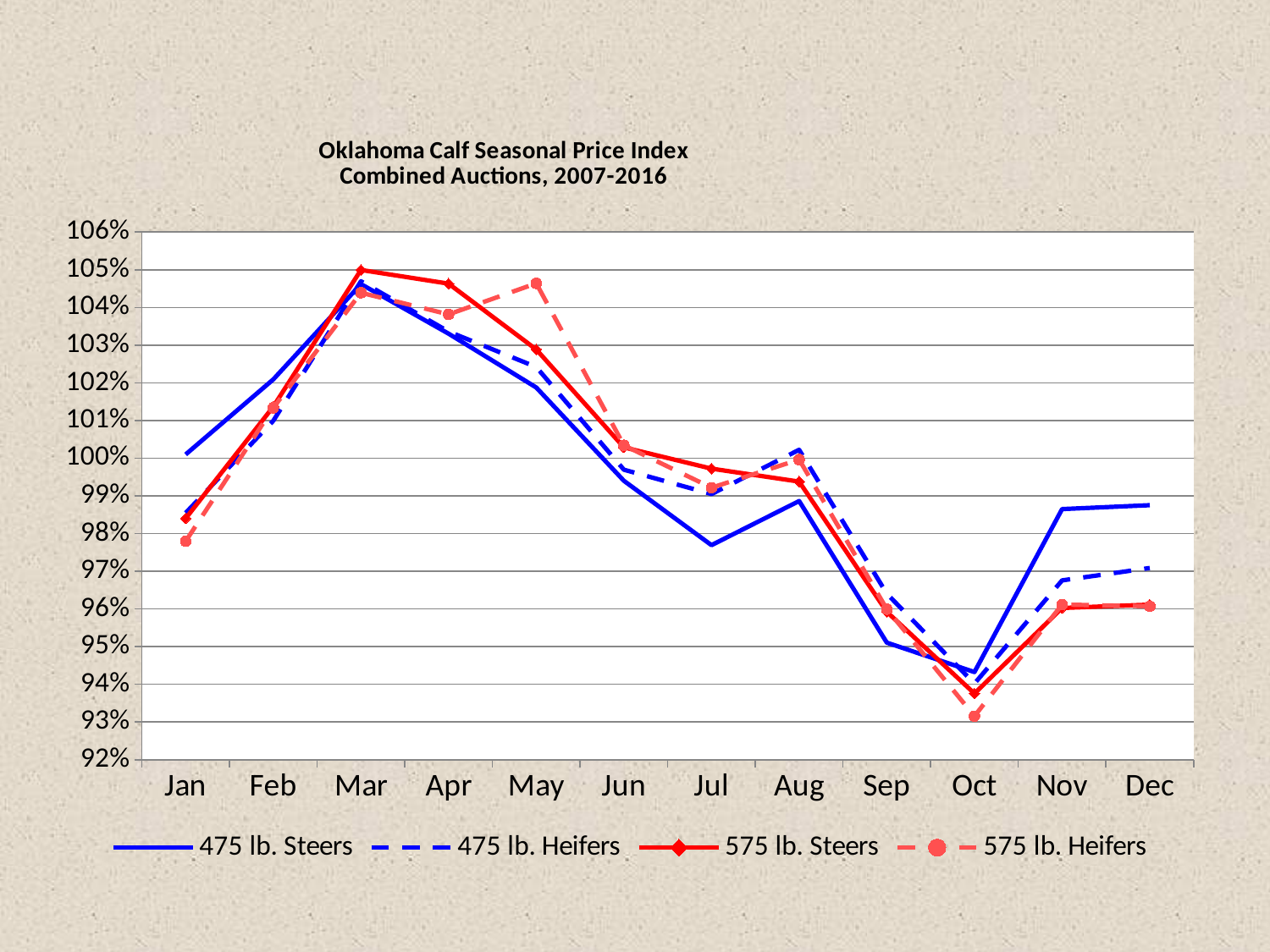
Is the value for 575 lb. Steers in Mar greater or less than 104%? greater In which month does the 575 lb. Heifers series reach its lowest value? Oct In Dec, which series has the higher value: 475 lb. Steers or 575 lb. Steers? 475 lb. Steers In Jan, which series has the higher value: 475 lb. Steers or 575 lb. Heifers? 475 lb. Steers How many series does the legend list? 4 In which month does the 575 lb. Steers series reach its highest value? Mar What kind of chart is shown on the slide? line chart In which month does the 475 lb. Steers series reach its lowest value? Oct How many months are plotted along the x axis? 12 Does the 575 lb. Steers series rise or fall from Mar to Oct? fall Is the value for 475 lb. Steers in Nov greater or less than 98%? greater Is the value for 575 lb. Heifers in Oct greater or less than 94%? less